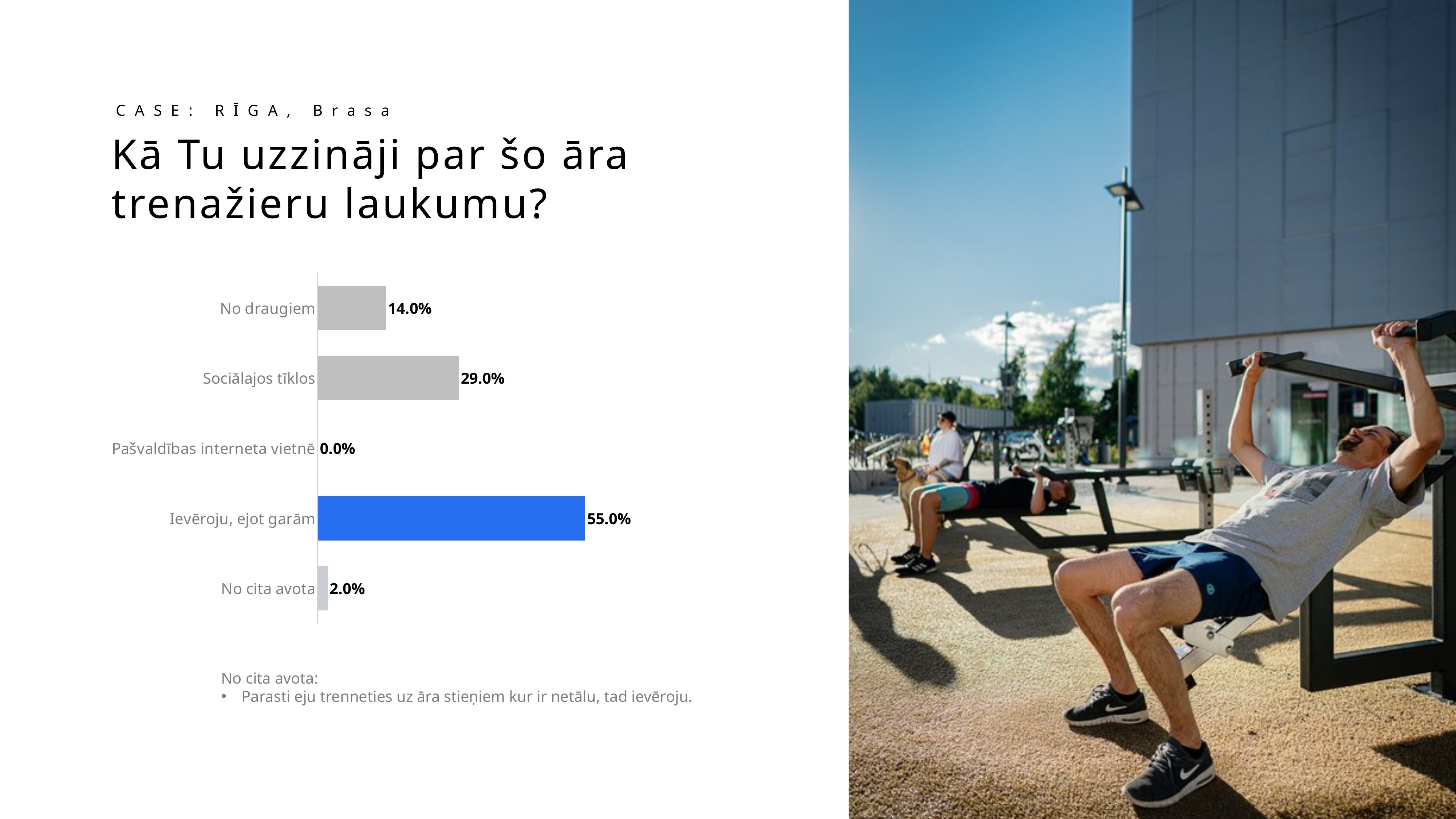
What kind of chart is shown on the slide? Bar chart What is the value for "Pašvaldības interneta vietnē"? 0.0% What is the value for "Sociālajos tīklos"? 29.0% How many categories does the chart show? 5 Which bar is coloured blue rather than grey? Ievēroju, ejot garām Which category has the highest value? Ievēroju, ejot garām What is the difference between "Ievēroju, ejot garām" and "Sociālajos tīklos"? 26.0% Which is larger, "No draugiem" or "Sociālajos tīklos"? Sociālajos tīklos What is the value for "No draugiem"? 14.0% Which category has the lowest value? Pašvaldības interneta vietnē What is the value for "Ievēroju, ejot garām"? 55.0% What is the value for "No cita avota"? 2.0%